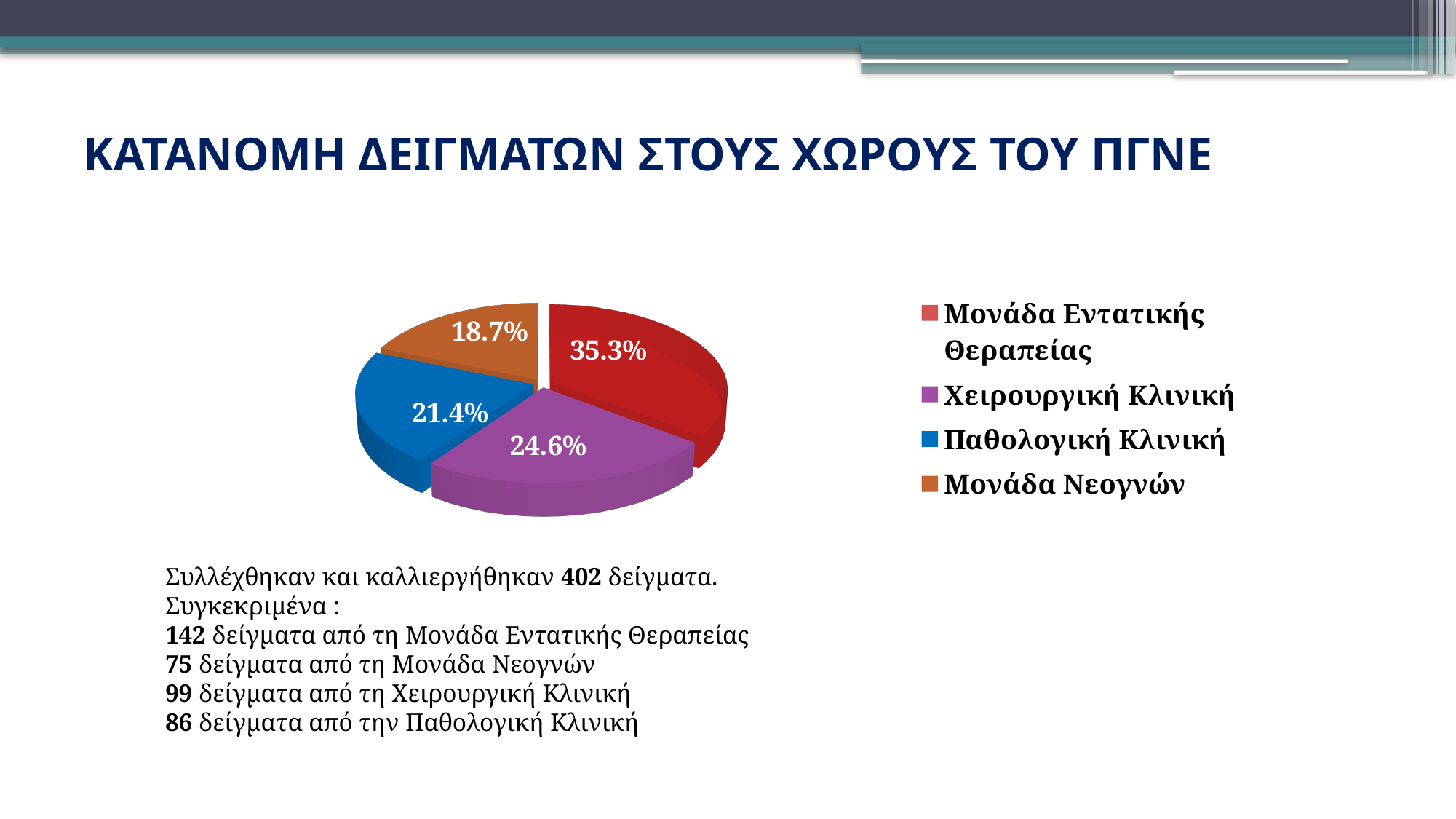
What share of the pie does Παθολογική Κλινική have? 21.4% How many slices does the pie chart have? 4 What share of the pie does Χειρουργική Κλινική have? 24.6% How many entries does the legend list? 4 Which slice is larger, Χειρουργική Κλινική or Παθολογική Κλινική? Χειρουργική Κλινική Which category has the largest slice of the pie? Μονάδα Εντατικής Θεραπείας What is the difference in percentage points between the Μονάδα Εντατικής Θεραπείας slice and the Μονάδα Νεογνών slice? 16.6 Which category has the smallest slice of the pie? Μονάδα Νεογνών What share of the pie does Μονάδα Εντατικής Θεραπείας have? 35.3% What kind of chart is shown on the slide? Pie chart What colour is the slice for Παθολογική Κλινική? Blue